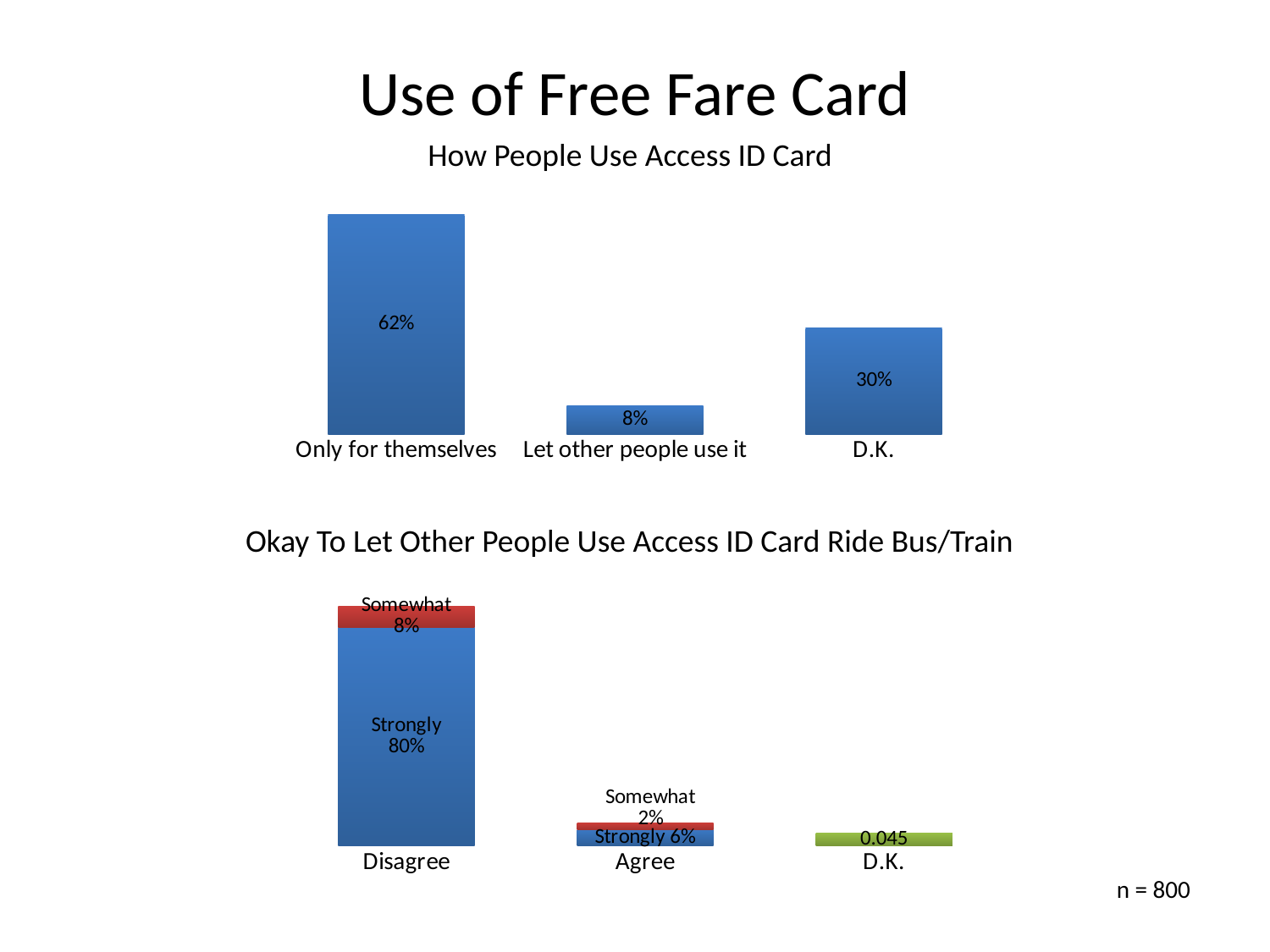
In the 'How People Use Access ID Card' chart, how many categories are shown? 3 What type of chart is the 'How People Use Access ID Card' chart? Bar chart In the 'How People Use Access ID Card' chart, which category has the lowest value? Let other people use it In the 'How People Use Access ID Card' chart, which category has the highest value? Only for themselves In the 'Okay To Let Other People Use Access ID Card Ride Bus/Train' chart, which is larger: the Strongly value for Disagree or the Strongly value for Agree? Disagree In the 'How People Use Access ID Card' chart, what is the value for 'Let other people use it'? 8% In the 'How People Use Access ID Card' chart, what is the difference between 'Only for themselves' and 'D.K.'? 32% In the 'How People Use Access ID Card' chart, what percentage of people use the card only for themselves? 62% In the 'Okay To Let Other People Use Access ID Card Ride Bus/Train' chart, what is the 'Somewhat' value for Agree? 2% In the 'Okay To Let Other People Use Access ID Card Ride Bus/Train' chart, what value is labelled on the D.K. bar? 0.045 In the 'Okay To Let Other People Use Access ID Card Ride Bus/Train' chart, what is the total of the Disagree bar? 88% In the 'Okay To Let Other People Use Access ID Card Ride Bus/Train' chart, what is the 'Strongly' value for Disagree? 80%